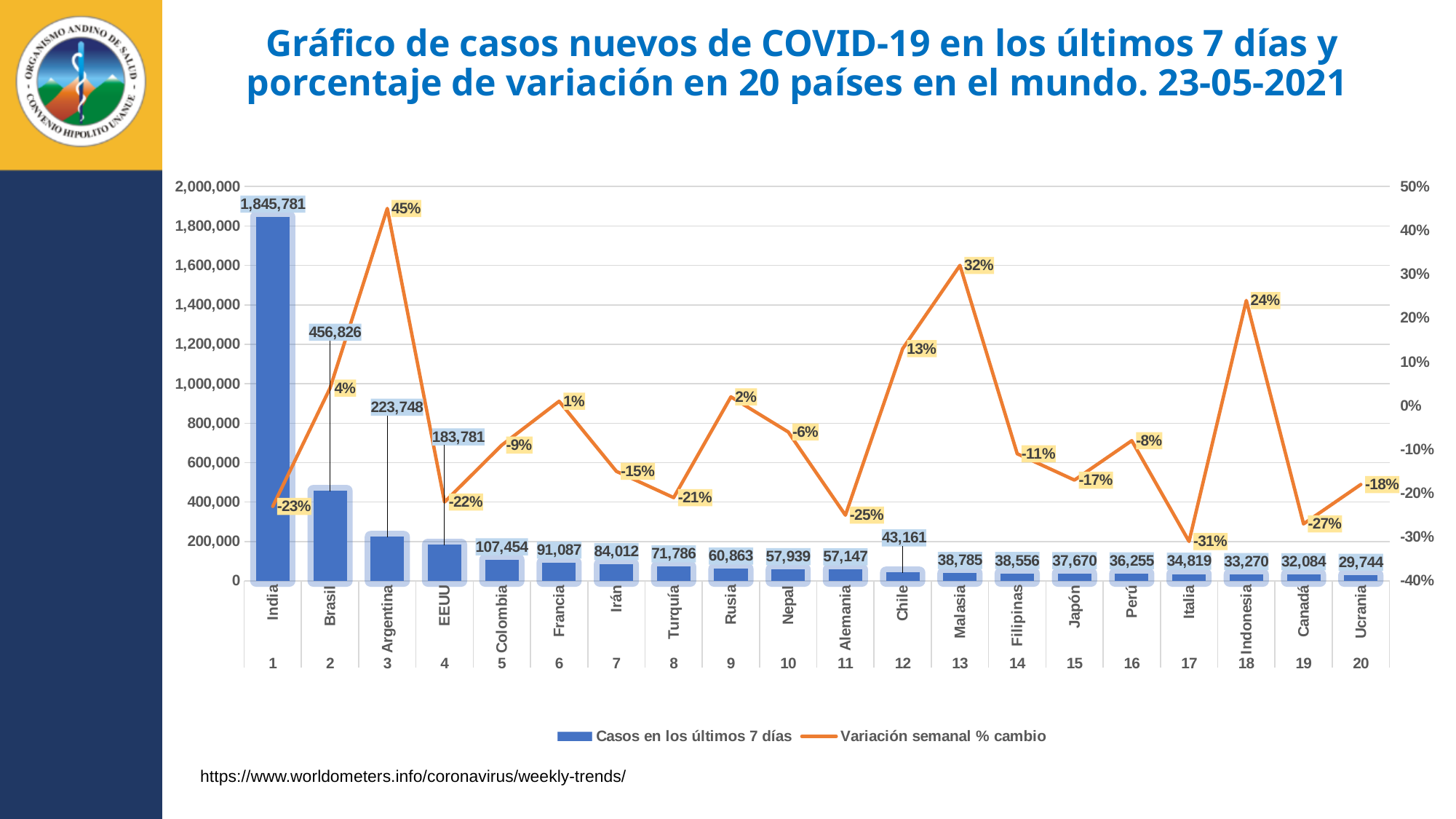
Which country has the highest weekly percentage variation? Argentina Which has more cases in the last 7 days, Chile or Malasia? Chile What kind of chart is used for the 'Casos en los últimos 7 días' series? Bar chart Which country has the highest number of cases in the last 7 days? India How many new COVID-19 cases in the last 7 days does the chart show for India? 1,845,781 What is the weekly percentage variation shown for Argentina? 45% How many countries are shown on the chart? 20 How many series does the legend list? 2 What is the number of cases in the last 7 days shown for Colombia? 107,454 What is the difference in cases in the last 7 days between Brasil and Argentina? 233,078 Which country has the lowest number of cases in the last 7 days? Ucrania What is the weekly percentage variation shown for Italia? -31%